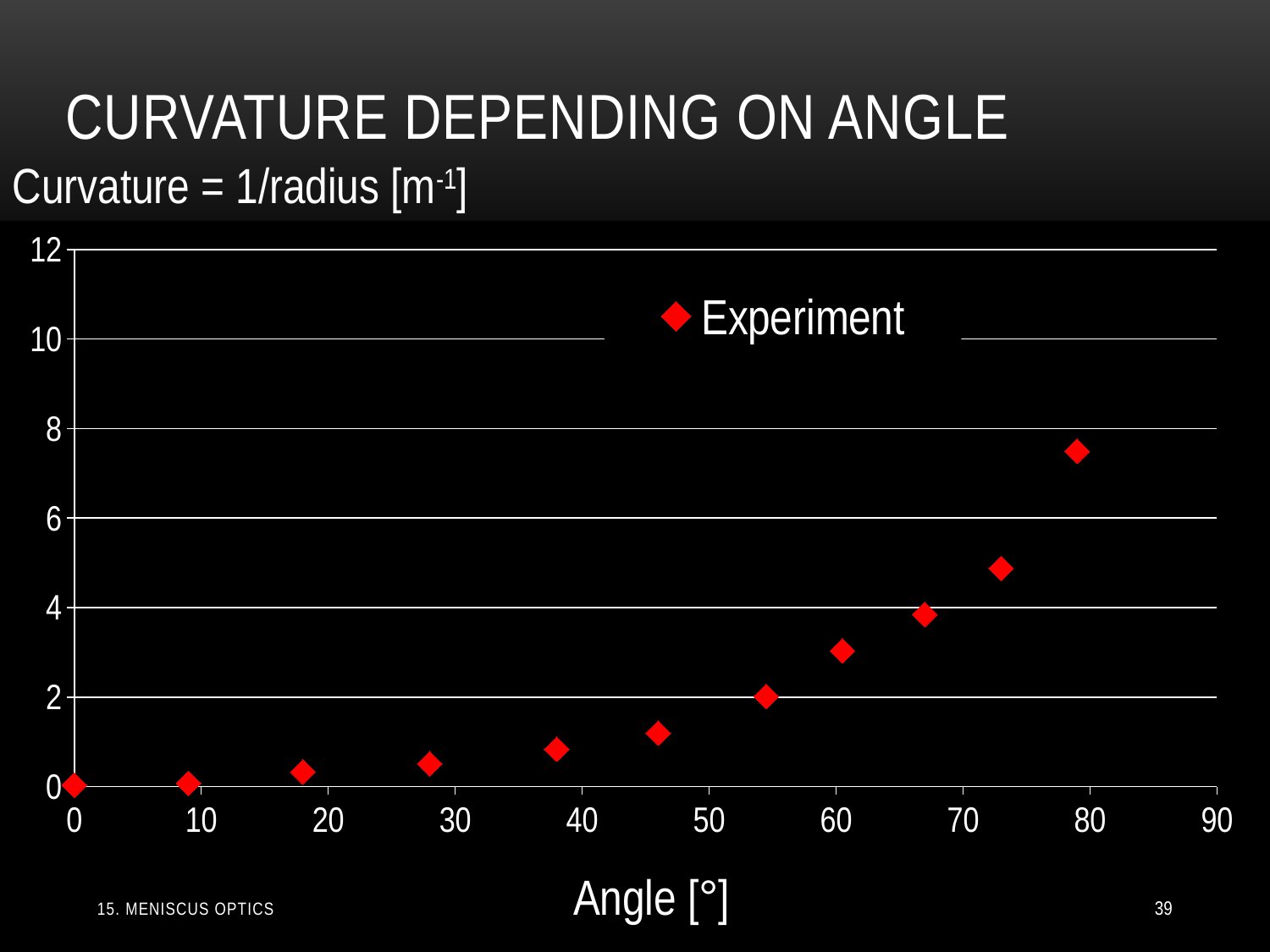
Do the curvature values rise or fall as the angle increases along the x axis? rise Which data point has the higher curvature, the one near 80° or the one near 10°? the one near 80° Is the curvature value of the data point near 70° greater or less than 2? greater Is the curvature value of the rightmost data point (near 80°) greater or less than 8? less What is the name of the series shown in the legend? Experiment Is the curvature value of the data point near 30° greater or less than 2? less How many data points are plotted in the chart? 11 How many series does the legend list? 1 What kind of chart is shown on the slide? scatter chart What is the label of the x axis? Angle [°]